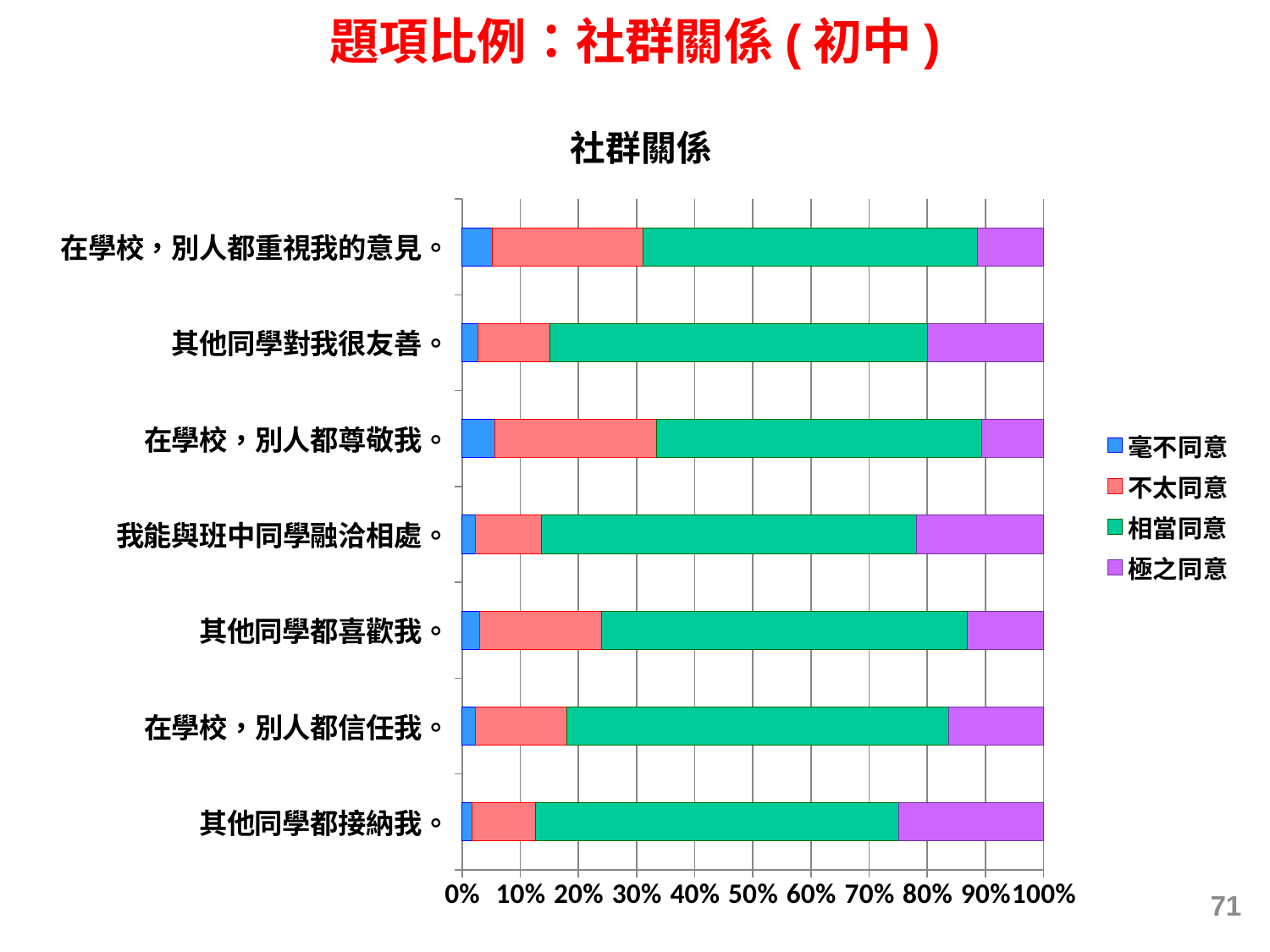
How many series does the legend list? 4 How many categories (statements) are plotted on the chart? 7 What is the title of the chart? 社群關係 Is the 相當同意 value for 其他同學對我很友善 greater or less than 60%? greater Which legend entry is shown in green? 相當同意 Is the 毫不同意 value for 在學校，別人都重視我的意見 greater or less than 10%? less Is the 不太同意 value for 在學校，別人都重視我的意見 greater or less than 20%? greater What is the total of the stacked bar for 其他同學都接納我? 100% Which has the larger 不太同意 value: 在學校，別人都尊敬我 or 其他同學對我很友善? 在學校，別人都尊敬我 What kind of chart is shown on the slide? stacked bar chart Which has the larger 極之同意 value: 其他同學都接納我 or 在學校，別人都尊敬我? 其他同學都接納我